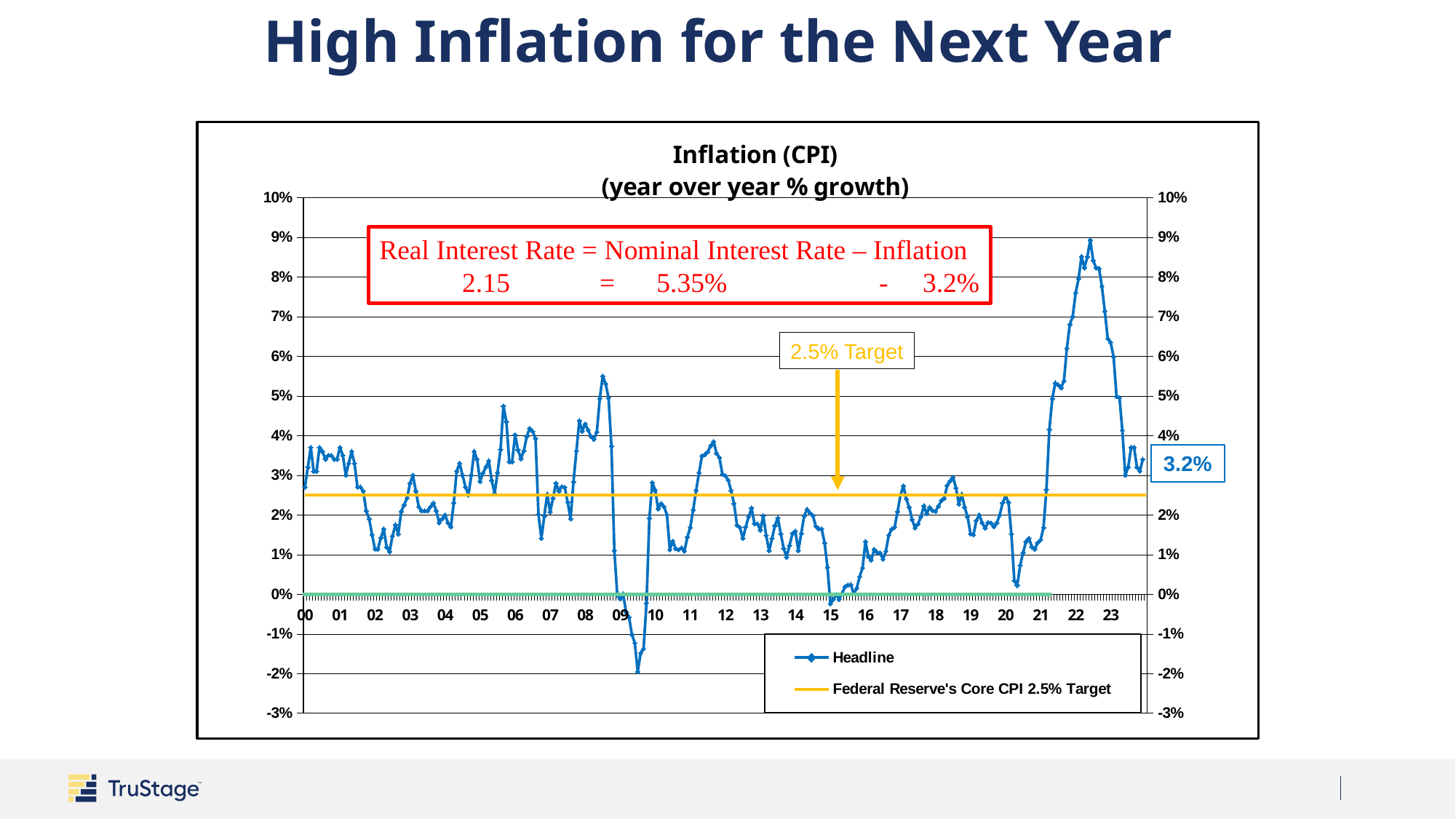
What kind of chart is shown on the slide? line chart Is the peak Headline inflation value reached in 2022 greater or less than 8%? greater Is the latest Headline inflation value of 3.2% greater or less than the 2.5% target? greater Is the lowest Headline inflation value, reached in 2009, greater or less than -1%? less How many series does the chart's legend list? 2 What is the title of the chart? Inflation (CPI) (year over year % growth) In which year does the Headline series reach its highest value? 22 What is the most recent Headline inflation value labeled on the chart? 3.2% By how many percentage points does the latest Headline value of 3.2% exceed the 2.5% target? 0.7 What value is the Federal Reserve's Core CPI target line set at? 2.5% What are the two entries listed in the chart's legend? Headline; Federal Reserve's Core CPI 2.5% Target In which year does the Headline series reach its lowest value? 09